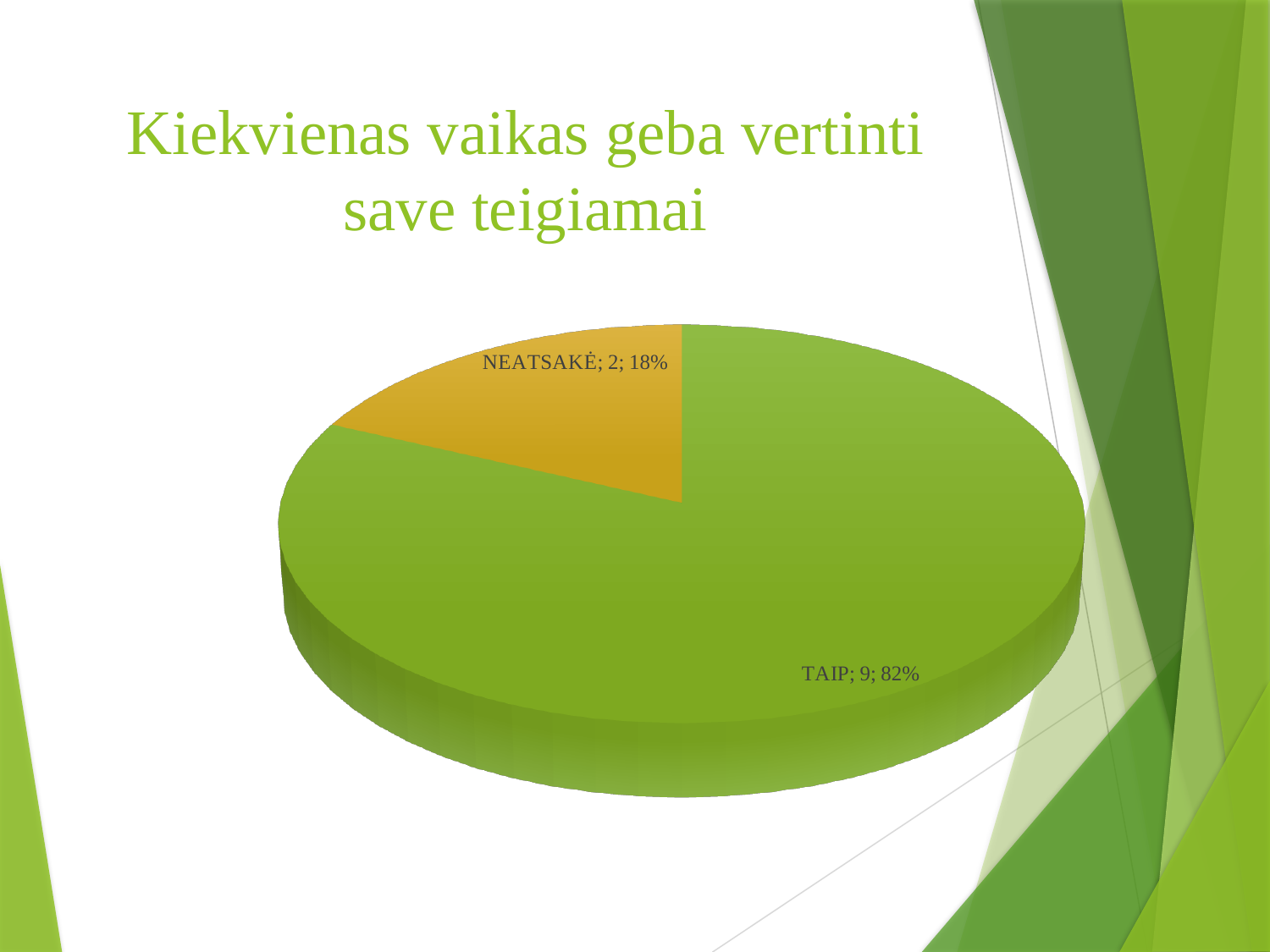
What share of the pie does NEATSAKĖ represent? 18% What is the difference between the values for TAIP and NEATSAKĖ? 7 What kind of chart is shown on the slide? pie chart What is the value for NEATSAKĖ? 2 Which is larger, TAIP or NEATSAKĖ? TAIP How many slices does the pie chart have? 2 What is the title of the slide containing the chart? Kiekvienas vaikas geba vertinti save teigiamai What share of the pie does TAIP represent? 82% Which slice is the smallest? NEATSAKĖ What is the value for TAIP? 9 Which slice is the largest? TAIP What is the total of the two slices? 11